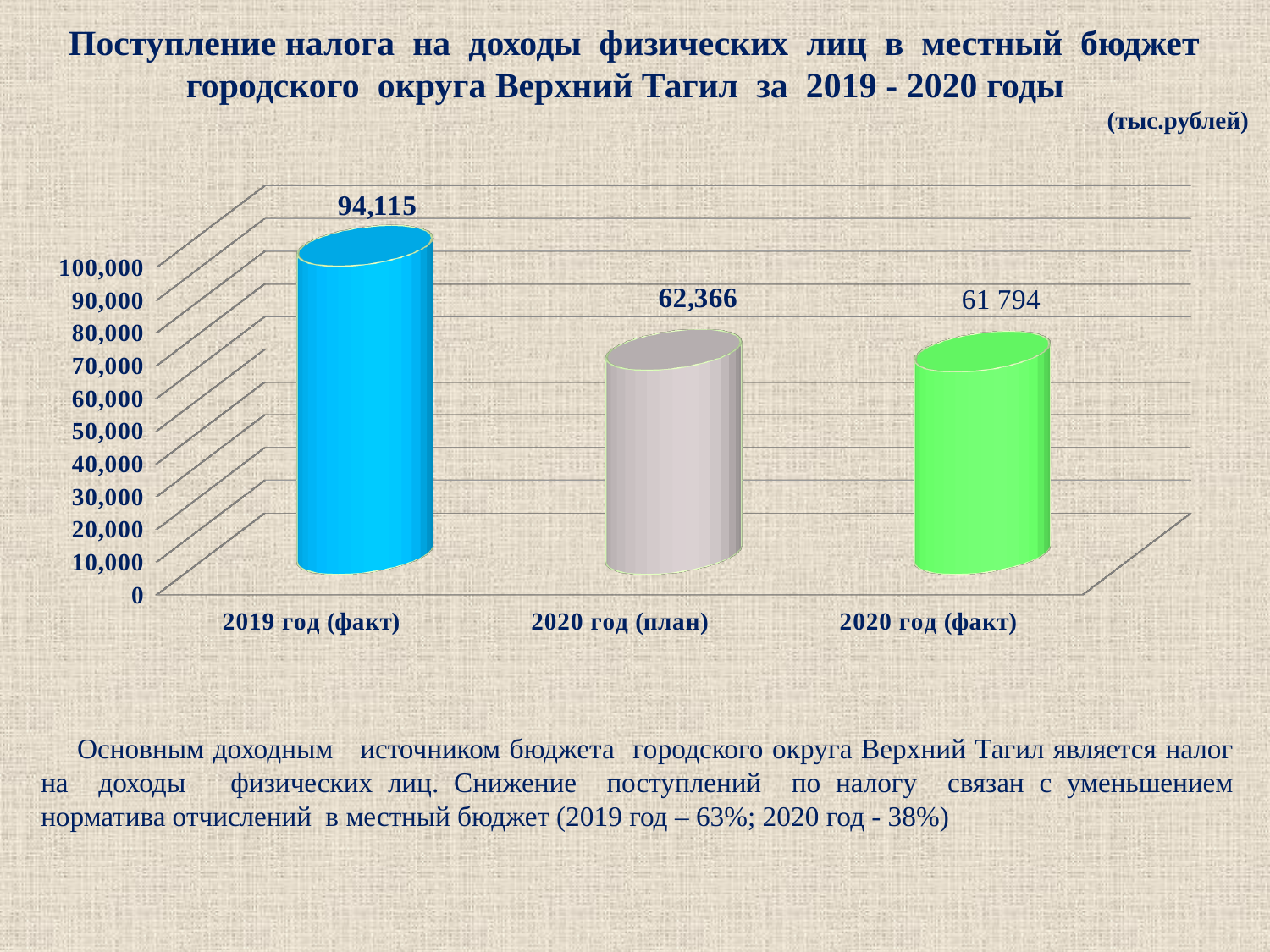
Is the value for 2020 год (план) greater or less than 70,000? less Which is larger, the value for 2019 год (факт) or the value for 2020 год (факт)? 2019 год (факт) What is the difference between the values for 2020 год (план) and 2020 год (факт)? 572 What is the value for 2020 год (факт)? 61 794 Which category has the lowest value? 2020 год (факт) Is the value for 2019 год (факт) greater or less than 90,000? greater What is the difference between the values for 2019 год (факт) and 2020 год (план)? 31,749 Do the values rise or fall from left to right along the x axis? fall Which category has the highest value? 2019 год (факт) What is the value for 2019 год (факт)? 94,115 How many categories are shown on the chart? 3 What is the value for 2020 год (план)? 62,366